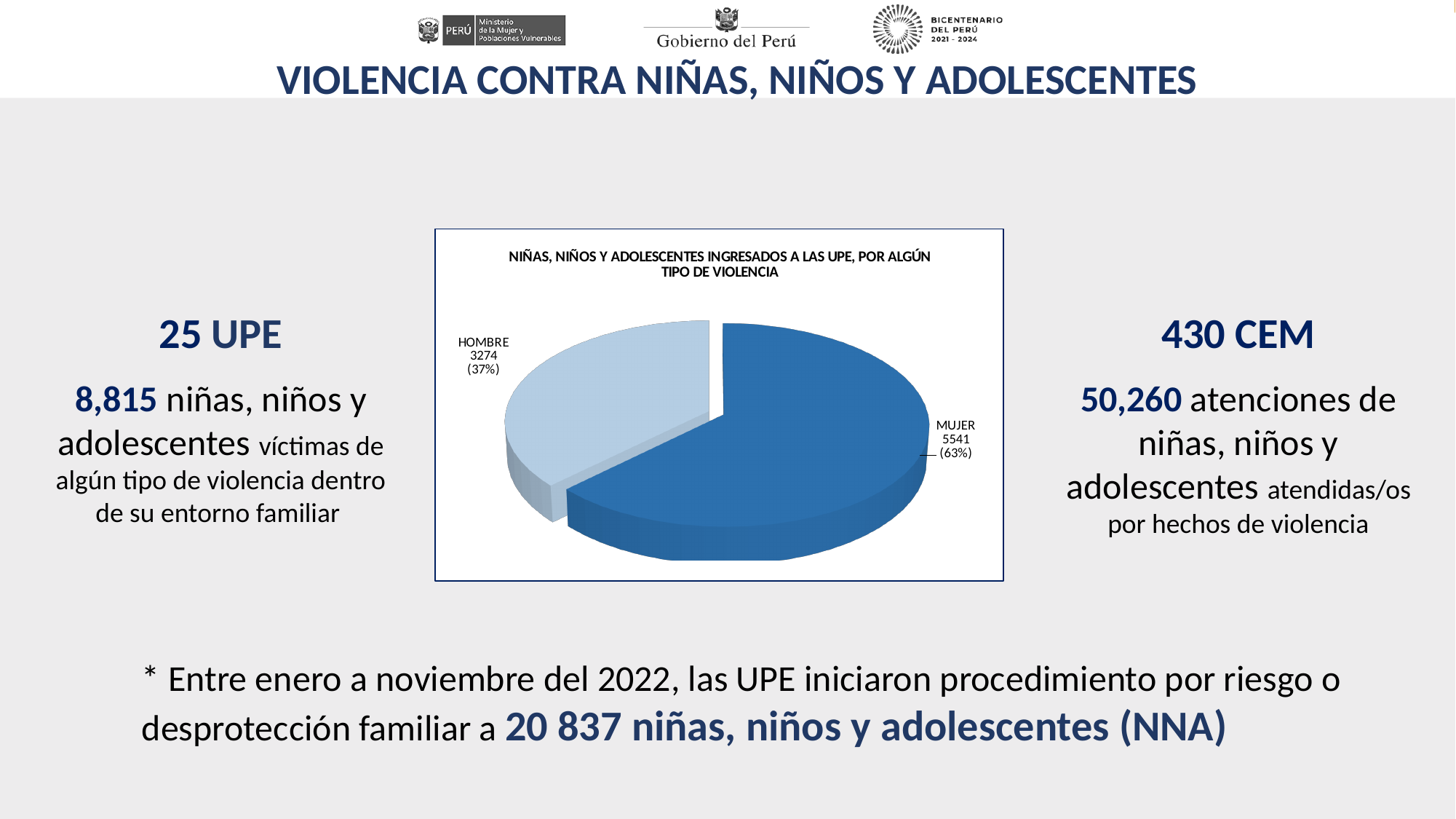
Which category has the largest slice in the pie chart? MUJER What is the difference between the MUJER and HOMBRE values? 2267 What is the value for HOMBRE in the pie chart? 3274 What is the total of the two slices in the pie chart? 8815 Which category has the smallest slice in the pie chart? HOMBRE What is the value for MUJER in the pie chart? 5541 Which is larger, the value for MUJER or the value for HOMBRE? MUJER What percentage share does the HOMBRE slice represent? 37% What kind of chart is shown on the slide? pie chart What is the title of the pie chart? NIÑAS, NIÑOS Y ADOLESCENTES INGRESADOS A LAS UPE, POR ALGÚN TIPO DE VIOLENCIA What percentage share does the MUJER slice represent? 63% How many categories are shown in the pie chart? 2